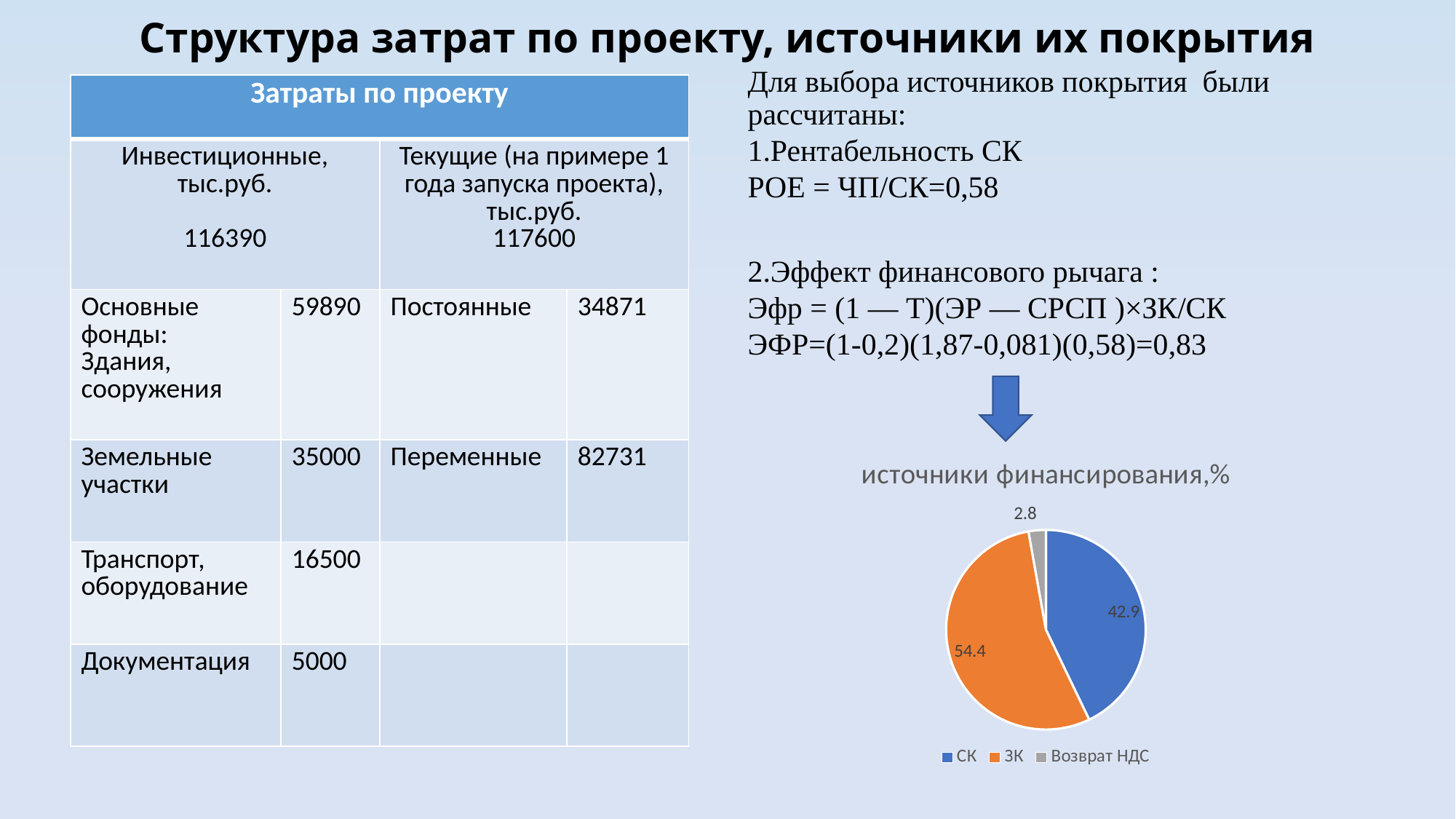
What kind of chart is shown on the slide? pie chart What is the difference between the values for СК and Возврат НДС in the pie chart? 40.1 What is the difference between the values for ЗК and СК in the pie chart? 11.5 What is the title of the pie chart? источники финансирования,% Which category has the smallest slice in the pie chart? Возврат НДС How many slices does the pie chart have? 3 How many entries does the legend of the pie chart list? 3 What is the value for ЗК in the pie chart? 54.4 What is the value for СК in the pie chart? 42.9 What is the value for Возврат НДС in the pie chart? 2.8 Which is larger in the pie chart, СК or ЗК? ЗК Which category has the largest slice in the pie chart? ЗК